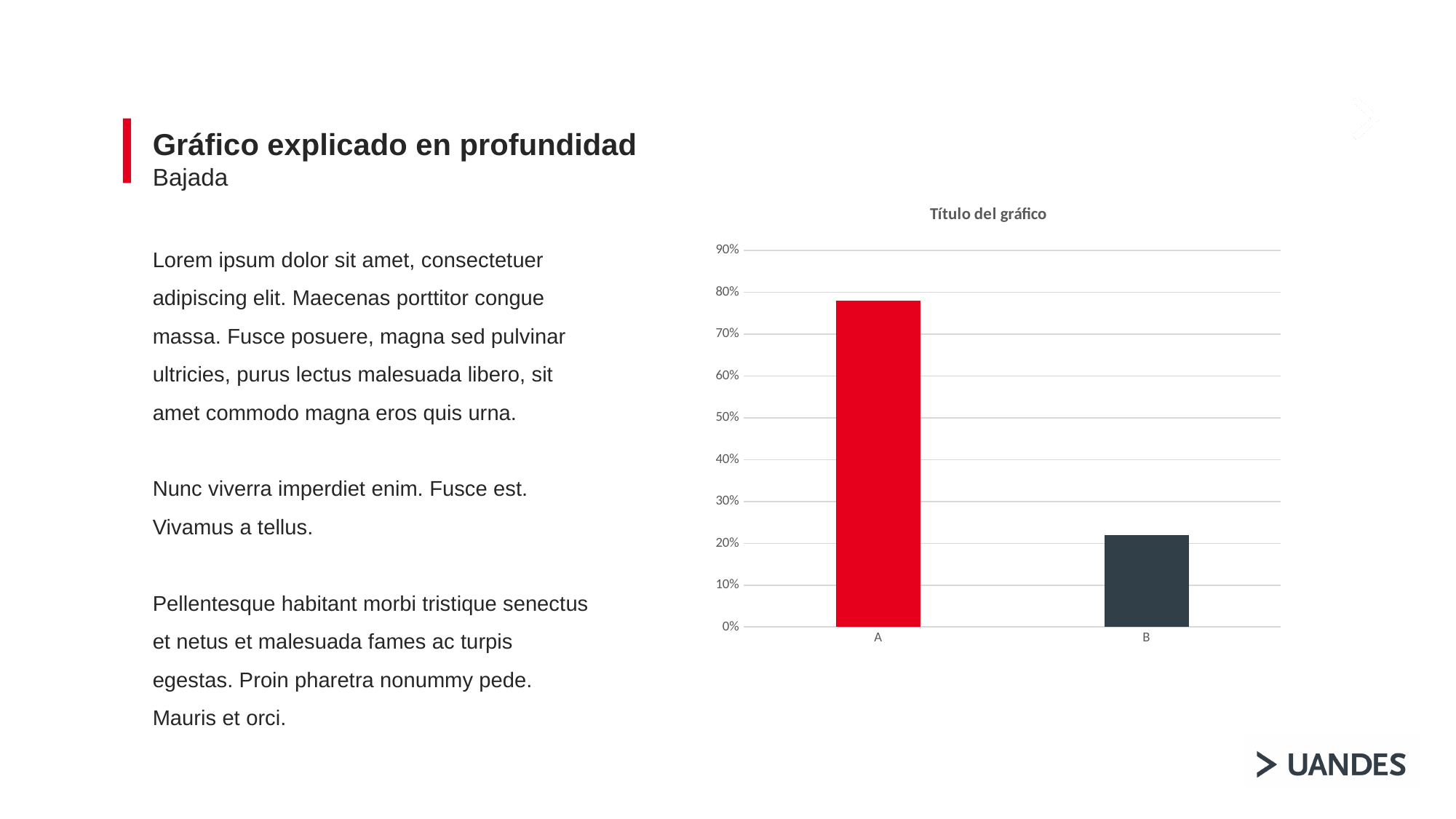
What colour is the bar for category A? red Is the value for B greater or less than 30%? less Do the values rise or fall from A to B along the x axis? fall Which category has the lowest value in the chart? B Is the value for A greater or less than 70%? greater Is the value for B greater or less than 20%? greater How many categories are shown on the x axis of the chart? 2 What kind of chart is shown on the slide? bar chart What is the title of the chart? Título del gráfico Which is larger, the value for A or the value for B? A Which category has the highest value in the chart? A